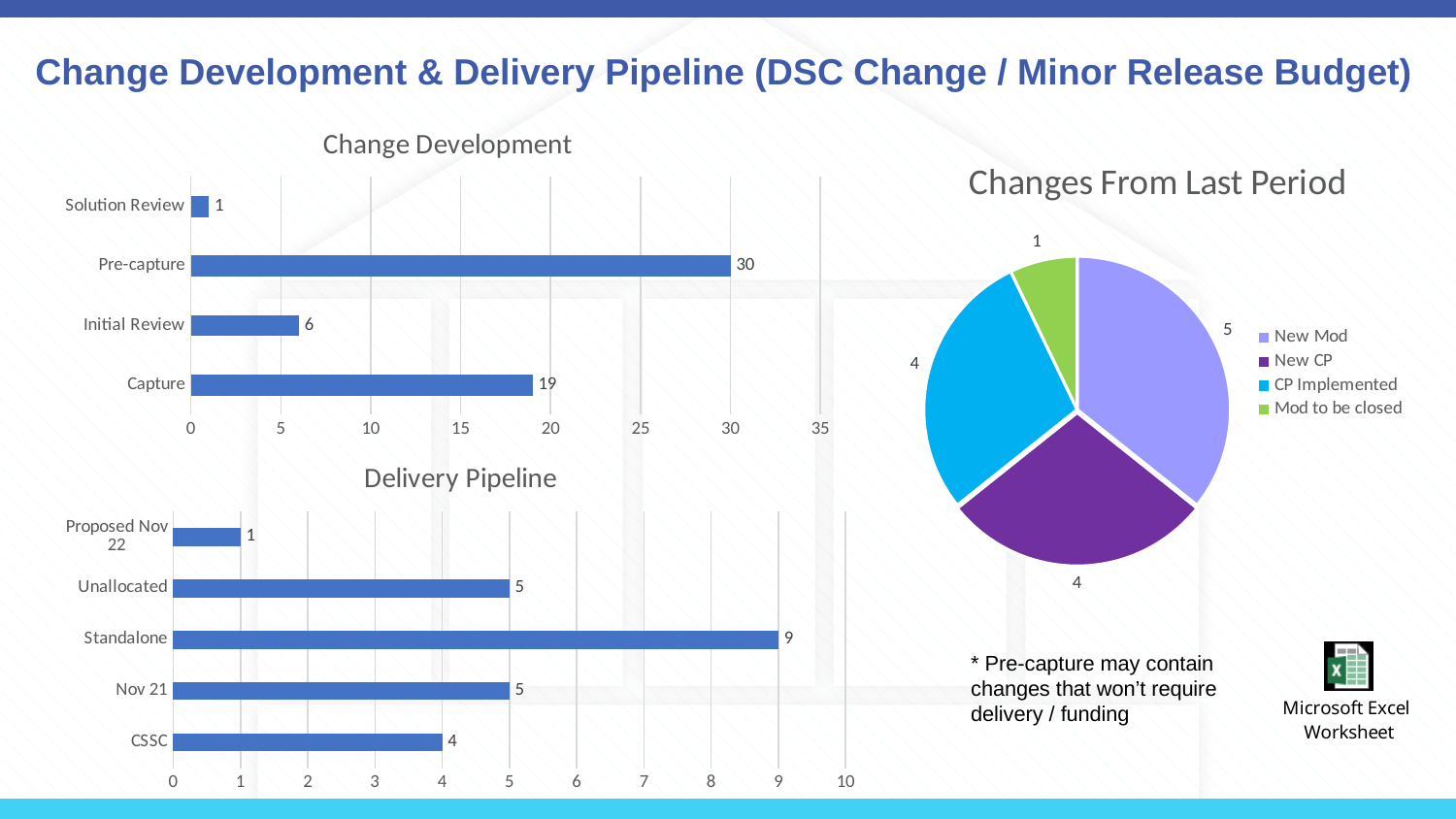
In the Change Development chart, which category has the lowest value? Solution Review In the Change Development chart, how many categories are shown? 4 How many entries does the legend of the Changes From Last Period chart list? 4 In the Delivery Pipeline chart, which is larger, CSSC or Nov 21? Nov 21 In the Delivery Pipeline chart, which category has the highest value? Standalone In the Changes From Last Period pie chart, which category has the smallest slice? Mod to be closed In the Delivery Pipeline chart, what is the value for Standalone? 9 In the Change Development chart, what is the difference between Pre-capture and Capture? 11 In the Change Development chart, what is the value for Pre-capture? 30 What kind of chart is the Delivery Pipeline chart? Bar chart In the Changes From Last Period pie chart, what is the value for New Mod? 5 In the Delivery Pipeline chart, how many categories are shown? 5